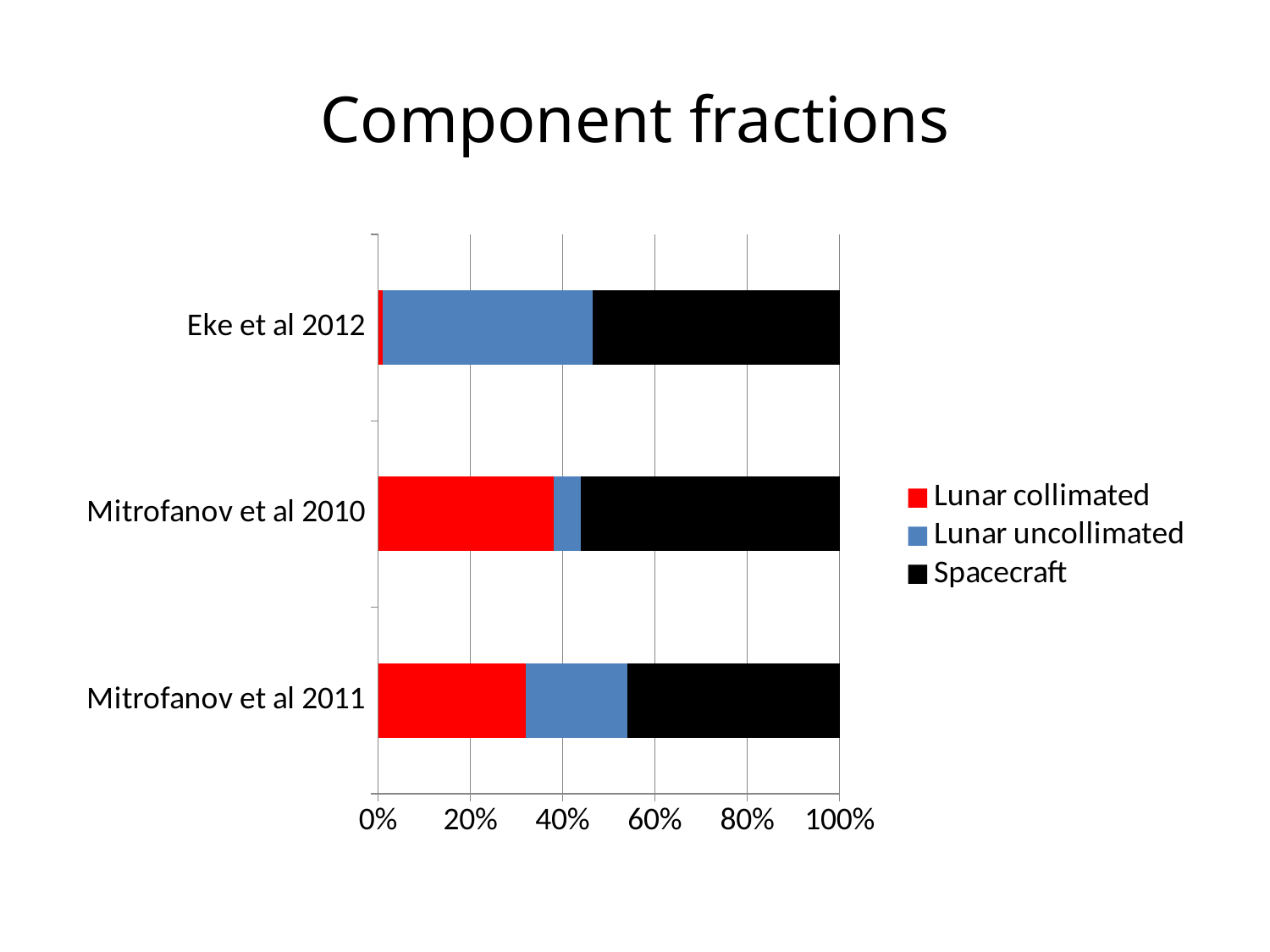
Is the Lunar uncollimated fraction for Mitrofanov et al 2010 greater or less than 20%? less Which category has the smallest Lunar collimated fraction? Eke et al 2012 Which category has the largest Lunar collimated fraction? Mitrofanov et al 2010 What kind of chart is shown on the slide? bar chart Which category has the largest Lunar uncollimated fraction? Eke et al 2012 What is the total of the stacked bar for Eke et al 2012? 100% How many series does the legend list? 3 How many categories are plotted on the chart? 3 What is the title of the chart? Component fractions Which category has the smallest Lunar uncollimated fraction? Mitrofanov et al 2010 Is the Lunar collimated fraction for Mitrofanov et al 2010 greater or less than 20%? greater Which colour represents the Spacecraft series? black